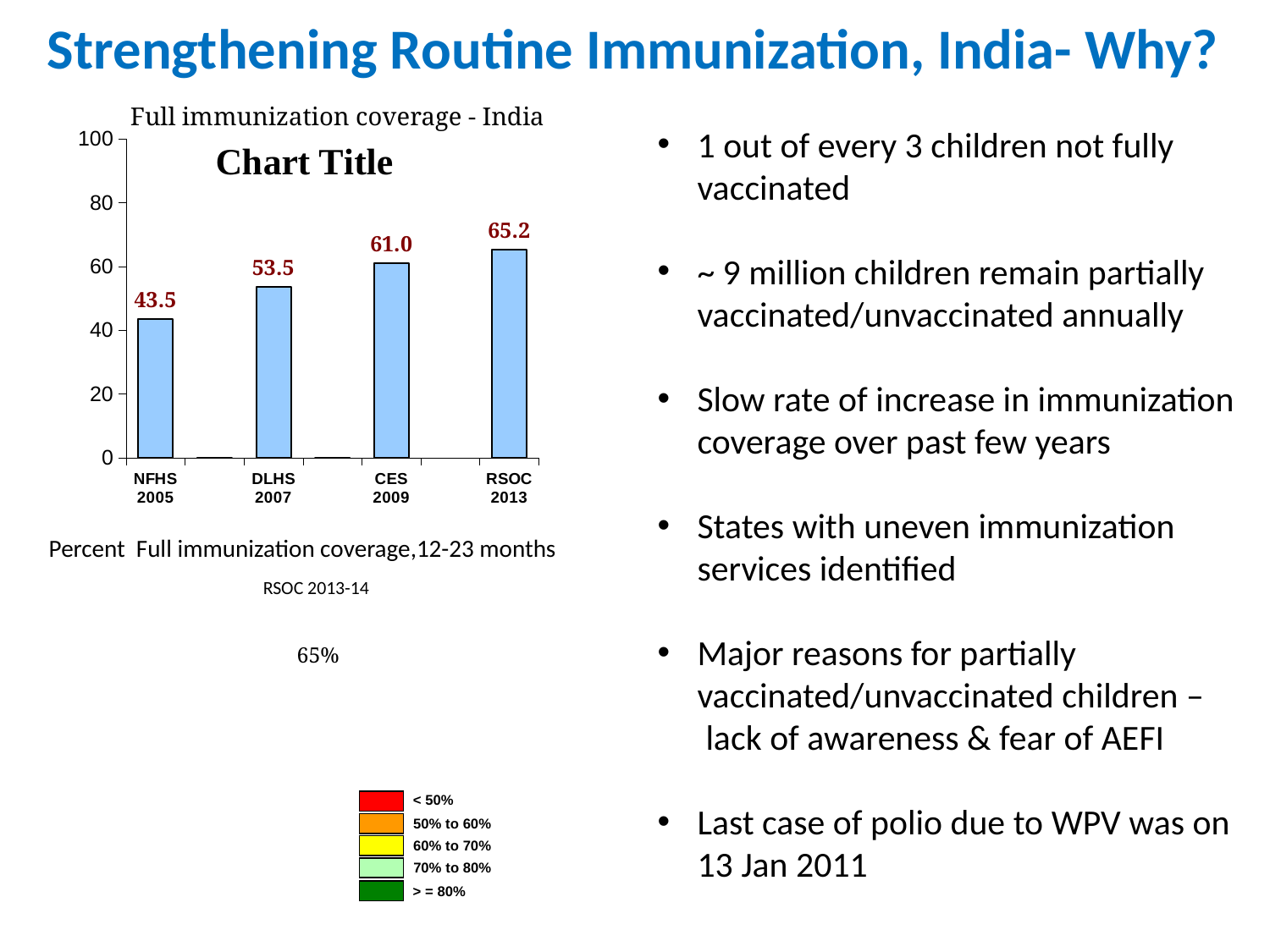
What is the full immunization coverage value for NFHS 2005? 43.5 How many surveys (bars) are shown in the chart? 4 Which is larger, the coverage for DLHS 2007 or CES 2009? CES 2009 What is the difference between the RSOC 2013 and NFHS 2005 coverage values? 21.7 What is the full immunization coverage value for RSOC 2013? 65.2 Do the coverage values rise or fall from NFHS 2005 to RSOC 2013? Rise What type of chart is used to show full immunization coverage? Bar chart What is the full immunization coverage value for DLHS 2007? 53.5 Which survey shows the lowest full immunization coverage? NFHS 2005 Which survey shows the highest full immunization coverage? RSOC 2013 What is the difference between the CES 2009 and DLHS 2007 coverage values? 7.5 What is the full immunization coverage value for CES 2009? 61.0